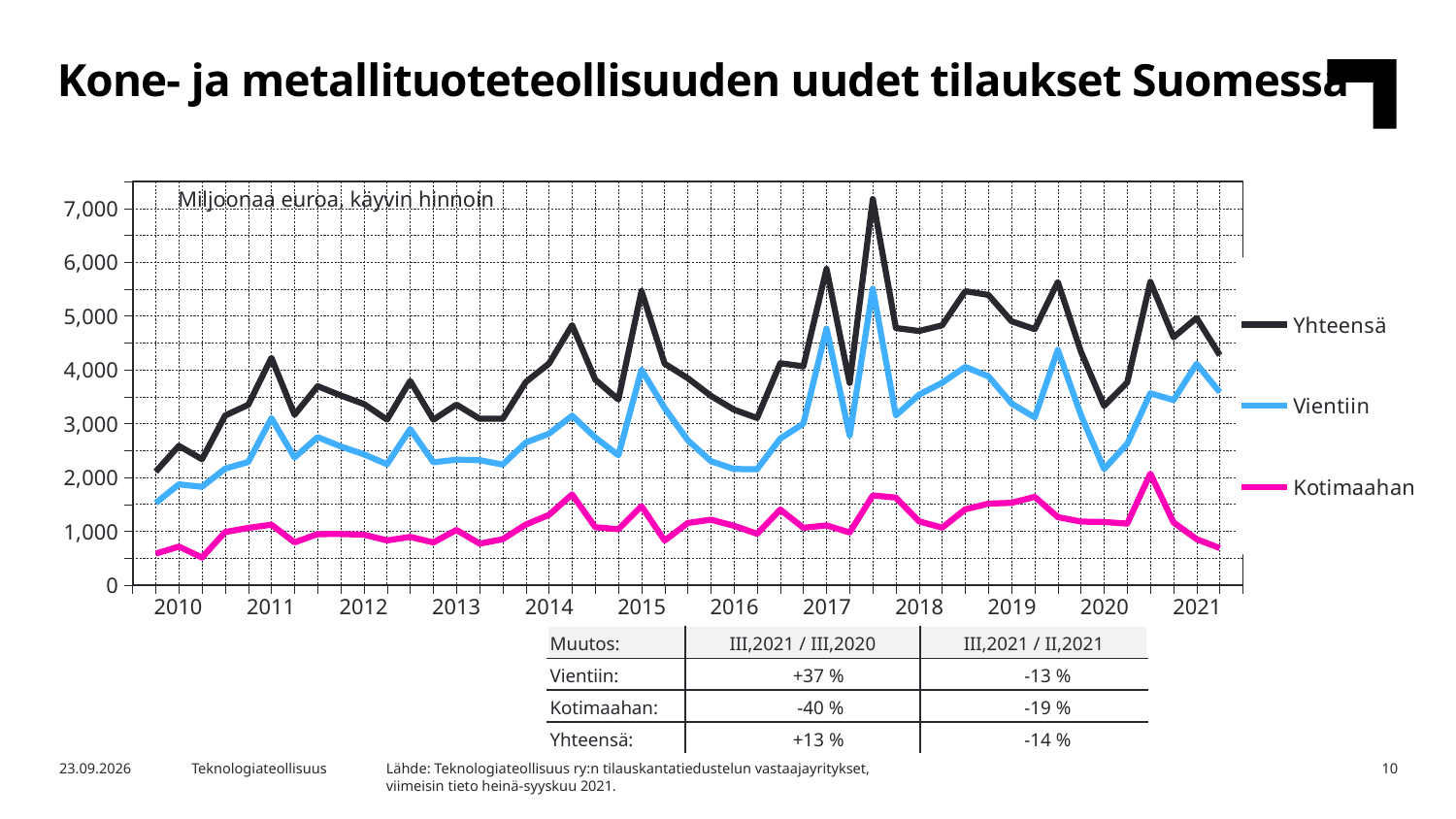
Which series reaches the highest value on the chart? Yhteensä Is the peak value of the Yhteensä line in 2017 greater or less than 7,000? greater Is the peak of the Vientiin line in 2017 greater or less than 5,000? greater Is the highest value of the Kotimaahan line greater or less than 3,000? less What kind of chart is shown on the slide? line chart How many series does the chart legend list? 3 What unit is stated in the label inside the chart area? Miljoonaa euroa, käyvin hinnoin Which series has the lowest values throughout the chart? Kotimaahan How many years are labelled on the x axis of the chart? 12 What are the three series named in the chart legend? Yhteensä, Vientiin, Kotimaahan At the start of 2010, which is larger: the Vientiin value or the Kotimaahan value? Vientiin